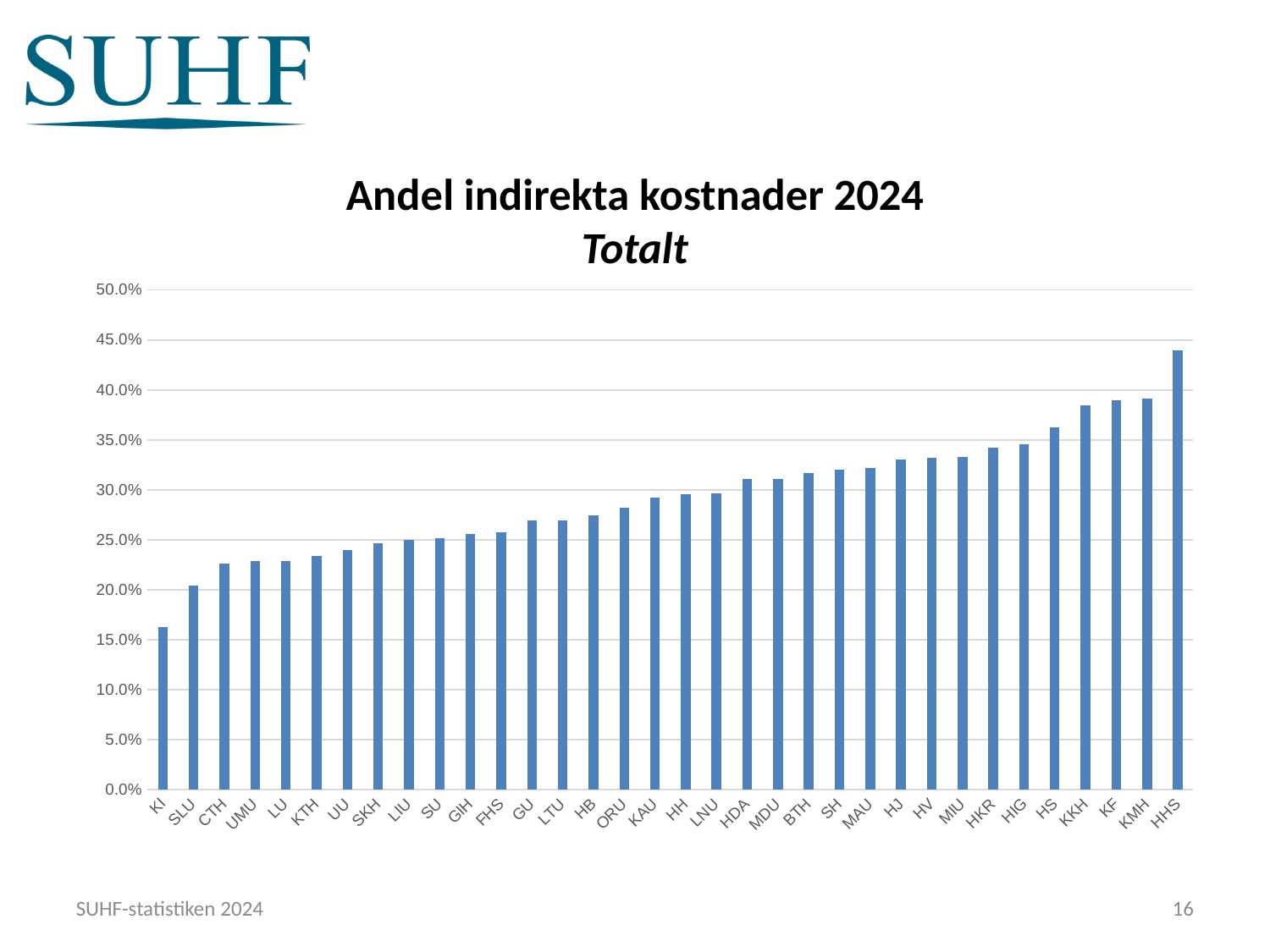
Is the value for KI greater or less than 20.0%? less Which has a larger value, CTH or HS? HS How many institutions are shown on the x axis of the chart? 34 What is the title of the chart? Andel indirekta kostnader 2024 Totalt Is the value for KKH greater or less than 40.0%? less Is the value for GU greater or less than 25.0%? greater Do the values rise or fall moving from left to right along the x axis? rise Which institution has the lowest share of indirect costs in the chart? KI What kind of chart is shown on the slide? bar chart Which institution has the highest share of indirect costs in the chart? HHS